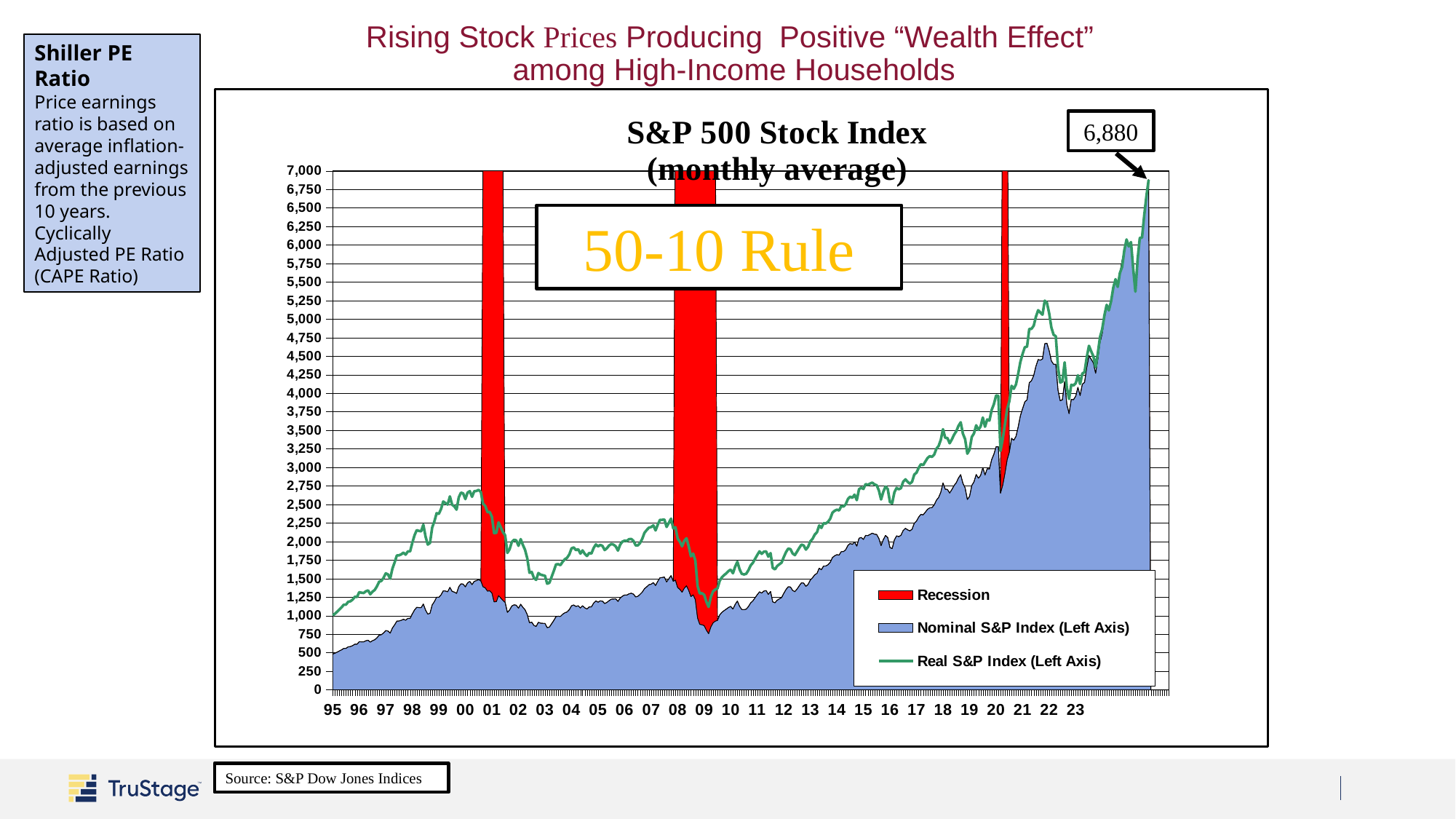
What is the title of the chart? S&P 500 Stock Index (monthly average) Is the Nominal S&P Index at its 2021-22 peak greater or less than 4,000? greater Does the Nominal S&P Index generally rise or fall from 1995 to the end of the chart? rise How many recession periods are shaded on the chart? 3 Is the Real S&P Index at its 2000 peak greater or less than 2,000? greater Is the Nominal S&P Index at its 2009 low greater or less than 1,000? less How many series does the chart legend list? 3 In 2010, which is higher: the Real S&P Index or the Nominal S&P Index? Real S&P Index What value is annotated at the end of the S&P 500 index series? 6,880 What colour is the Real S&P Index line? green What kind of chart is shown on the slide? area and line chart